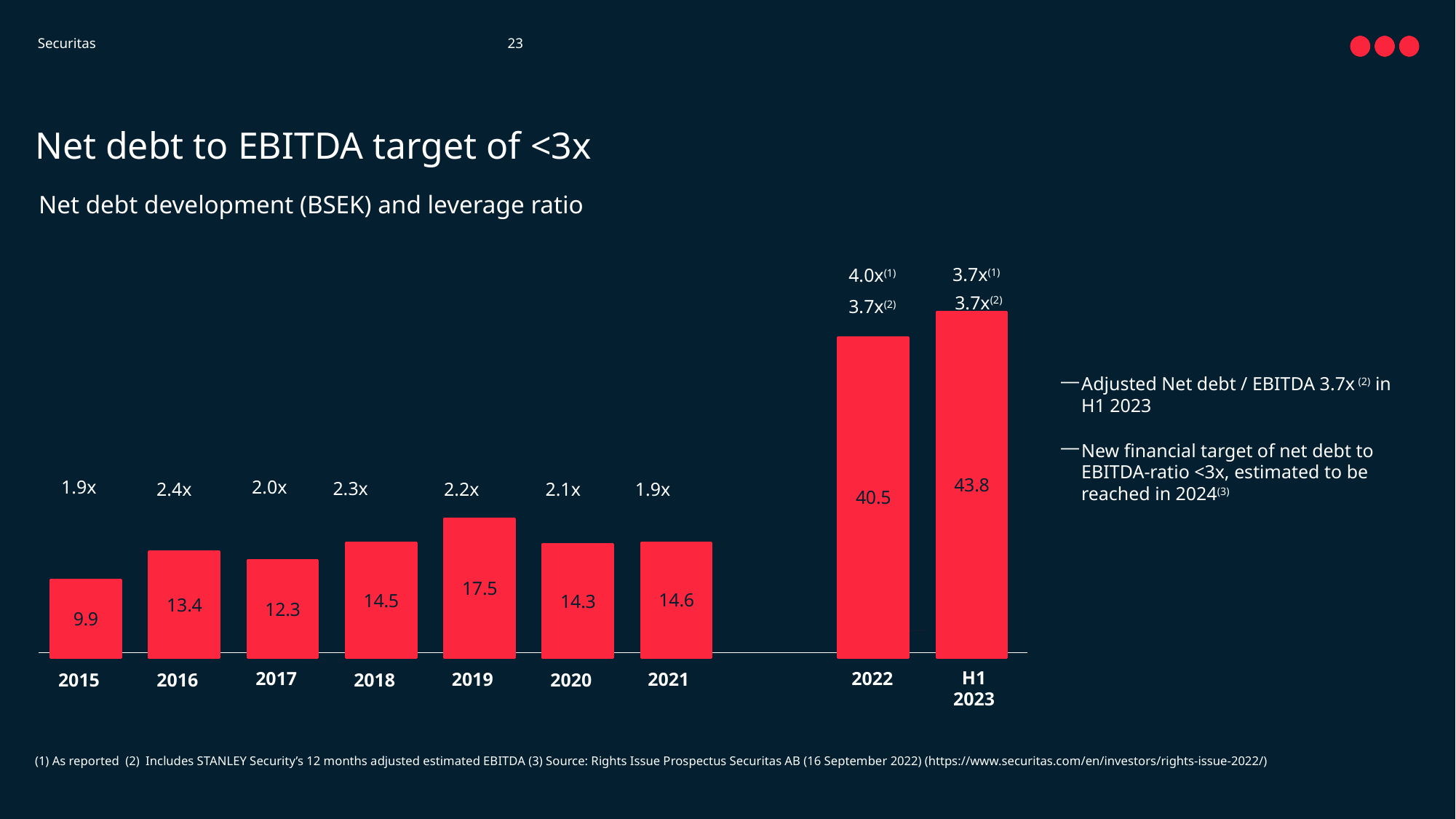
What is the difference in net debt between 2022 and 2021? 25.9 What is the difference in net debt between H1 2023 and 2022? 3.3 What is the net debt value shown for 2019? 17.5 What leverage ratio is shown above the 2016 bar? 2.4x What kind of chart is shown on the slide? Bar chart How many bars are plotted in the chart? 9 What is the as-reported leverage ratio (1) shown for 2022? 4.0x Which period has the highest net debt bar? H1 2023 What is the net debt value shown for H1 2023? 43.8 Which has the larger net debt value, 2018 or 2020? 2018 Which year has the lowest net debt bar? 2015 What is the subtitle of the chart? Net debt development (BSEK) and leverage ratio